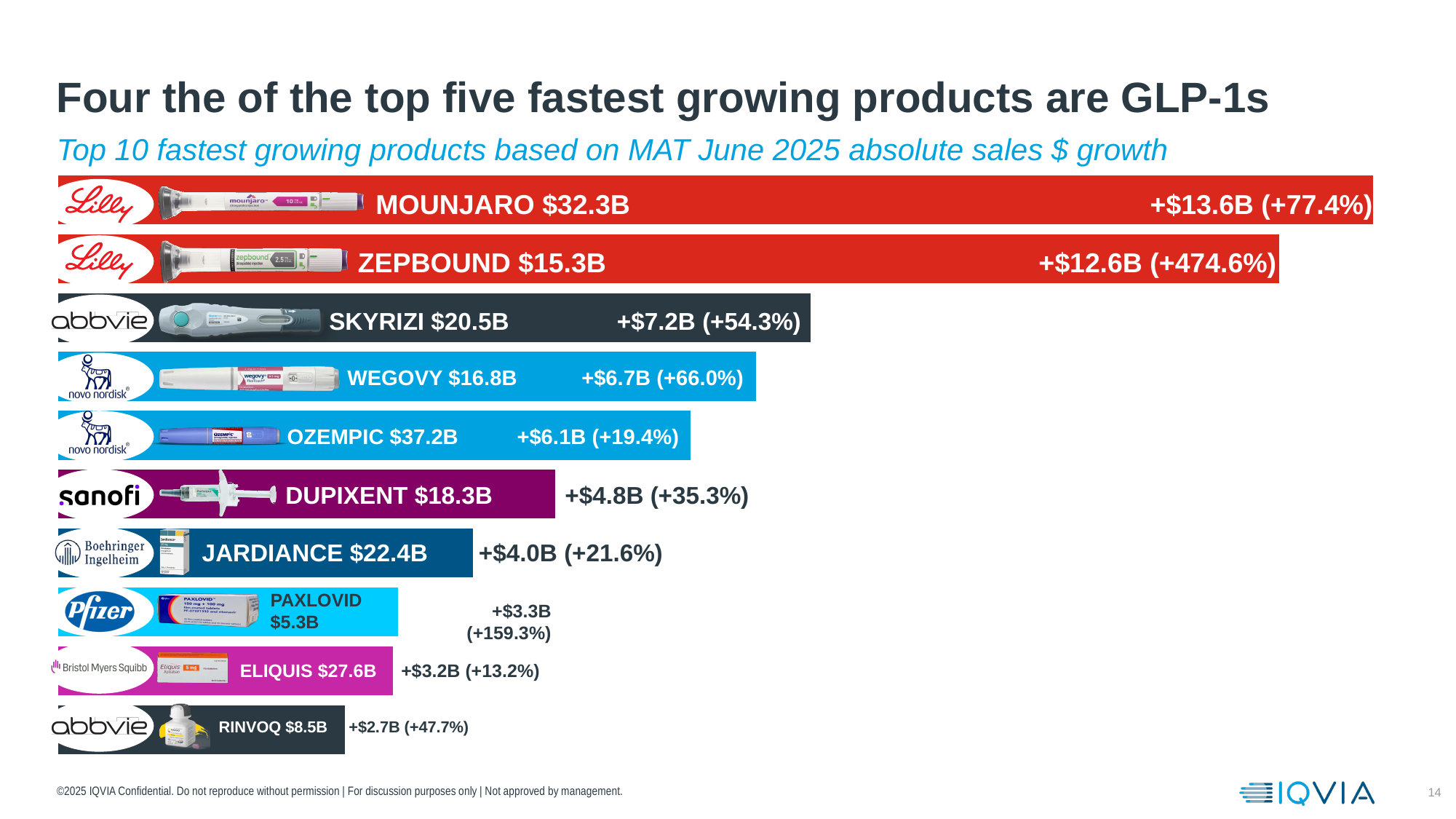
What percentage growth is shown for Zepbound? +474.6% Which product has the smallest absolute sales growth? Rinvoq What is the absolute sales growth shown for Mounjaro? +$13.6B Which product has the largest absolute sales growth? Mounjaro What is the absolute sales growth shown for Skyrizi? +$7.2B What is the difference in absolute sales growth between Mounjaro and Zepbound? $1.0B How many products are shown in the chart? 10 Do the absolute growth values rise or fall from the top bar to the bottom bar? Fall What is the subtitle of the chart? Top 10 fastest growing products based on MAT June 2025 absolute sales $ growth Which has the larger absolute sales growth, Wegovy or Ozempic? Wegovy What total sales figure is shown next to Ozempic? $37.2B What kind of chart is shown on the slide? Bar chart